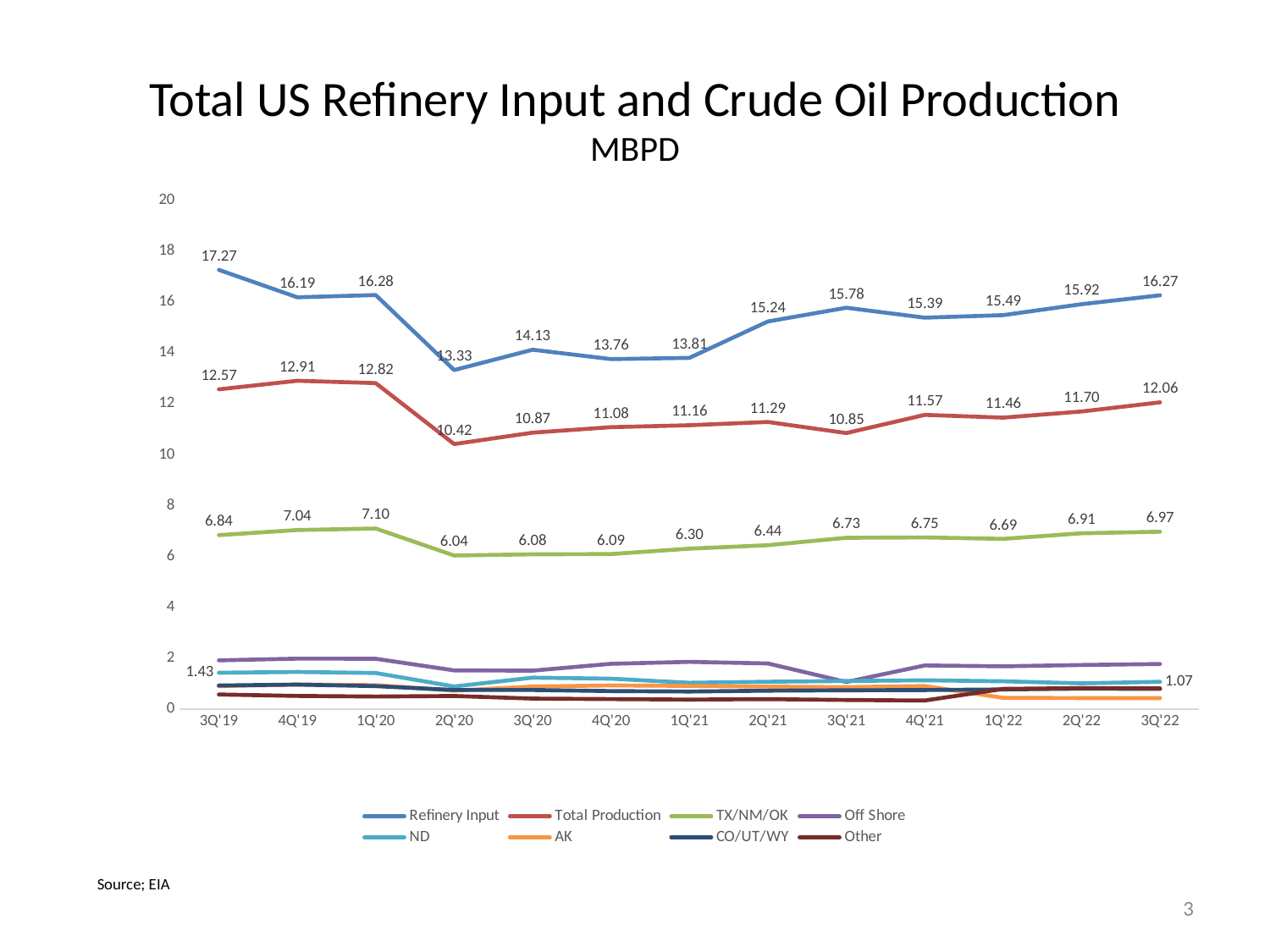
What is the Refinery Input value for 2Q'20? 13.33 How many quarters are shown on the x axis? 13 What kind of chart is shown on the slide? line chart What is the Total Production value for 3Q'22? 12.06 What is the difference between Refinery Input and Total Production in 3Q'22? 4.21 What is the ND value for 3Q'19? 1.43 In which quarter is TX/NM/OK highest? 1Q'20 In which quarter is Total Production lowest? 2Q'20 In which quarter is Refinery Input highest? 3Q'19 How many series does the legend list? 8 Is the Off Shore value for 3Q'21 greater or less than 2? less Which is larger for TX/NM/OK: the value in 1Q'20 or the value in 3Q'22? 1Q'20